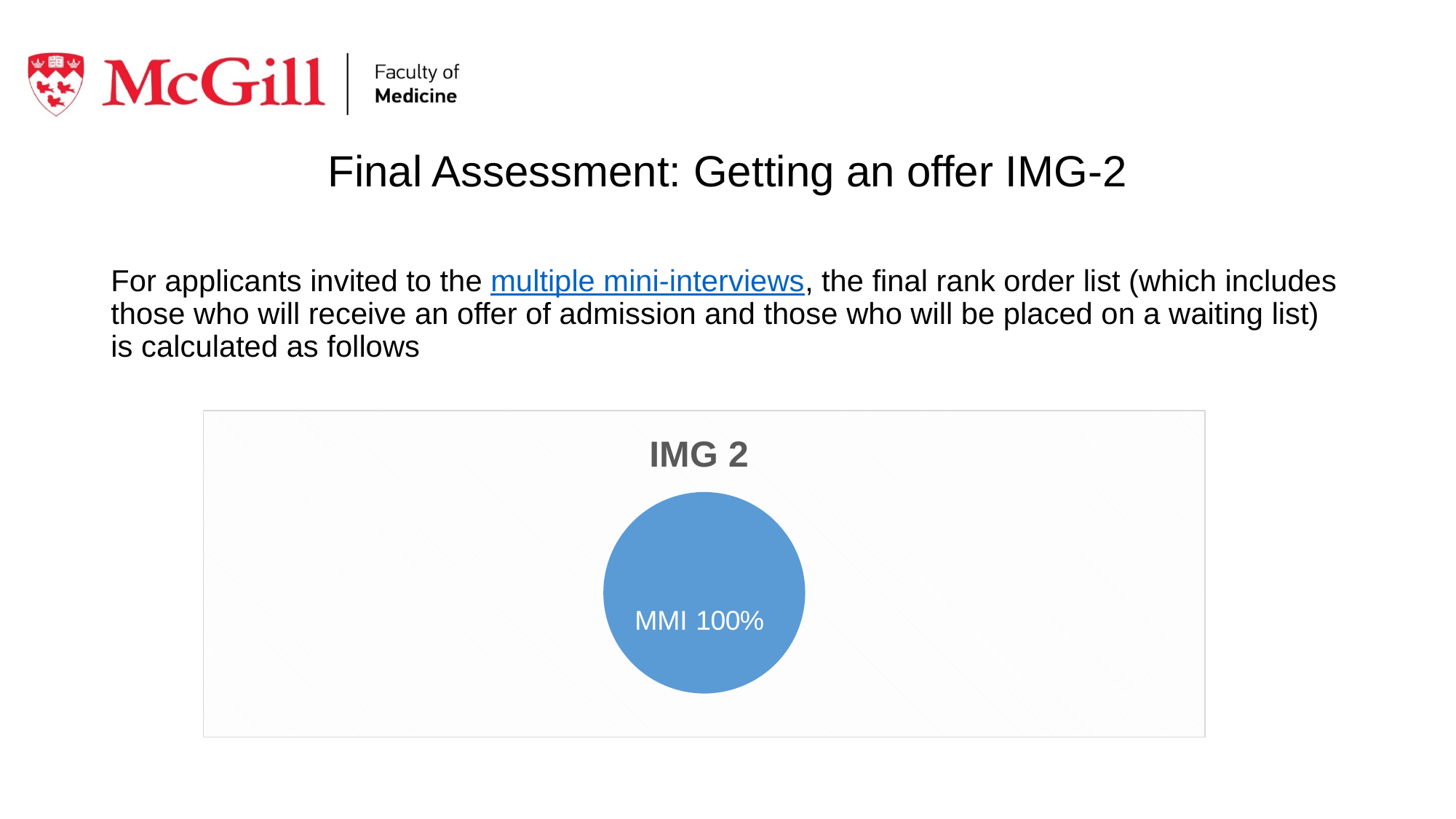
What share of the pie does MMI account for? 100% How many slices does the pie chart have? 1 What value is labelled on the MMI slice? 100% Which component makes up the entire pie chart? MMI What kind of chart is shown on the slide? pie chart What is the title of the chart? IMG 2 What colour is the MMI slice? blue